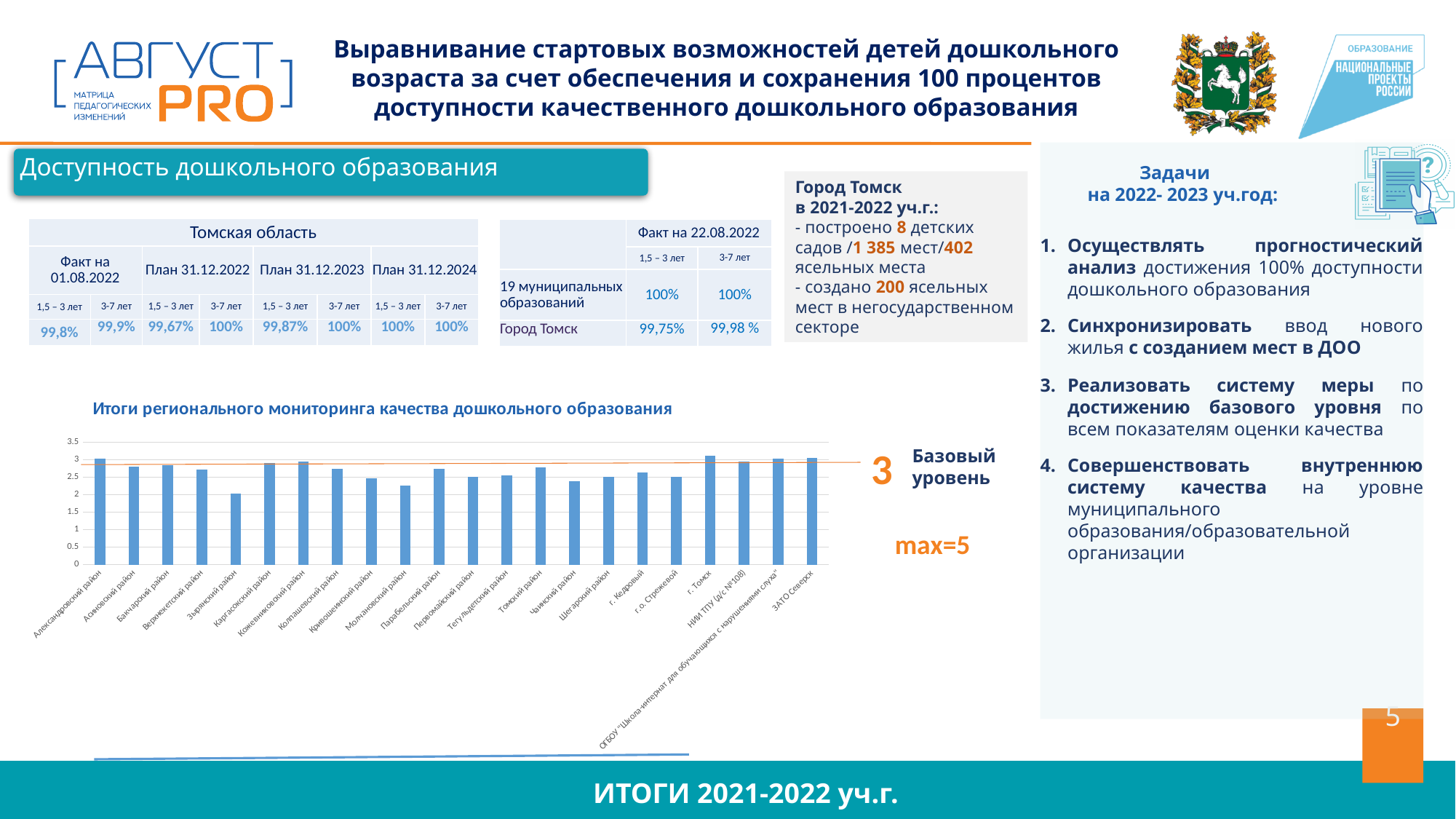
What is the maximum possible score noted next to the chart "Итоги регионального мониторинга качества дошкольного образования"? max=5 How many categories (bars) are shown in the chart "Итоги регионального мониторинга качества дошкольного образования"? 22 In the chart "Итоги регионального мониторинга качества дошкольного образования", is the value for Кожевниковский район greater or less than 2.5? greater In the chart "Итоги регионального мониторинга качества дошкольного образования", which is larger: Зырянский район or Каргасокский район? Каргасокский район In the chart "Итоги регионального мониторинга качества дошкольного образования", which is larger: Кривошеинский район or Кожевниковский район? Кожевниковский район In the chart "Итоги регионального мониторинга качества дошкольного образования", which category has the lowest bar? Зырянский район What level does the orange horizontal line labelled "Базовый уровень" mark on the chart? 3 In the chart "Итоги регионального мониторинга качества дошкольного образования", is the value for Чаинский район greater or less than 2.5? less In the chart "Итоги регионального мониторинга качества дошкольного образования", is the value for Александровский район greater or less than 2.5? greater What kind of chart is used for "Итоги регионального мониторинга качества дошкольного образования"? bar chart